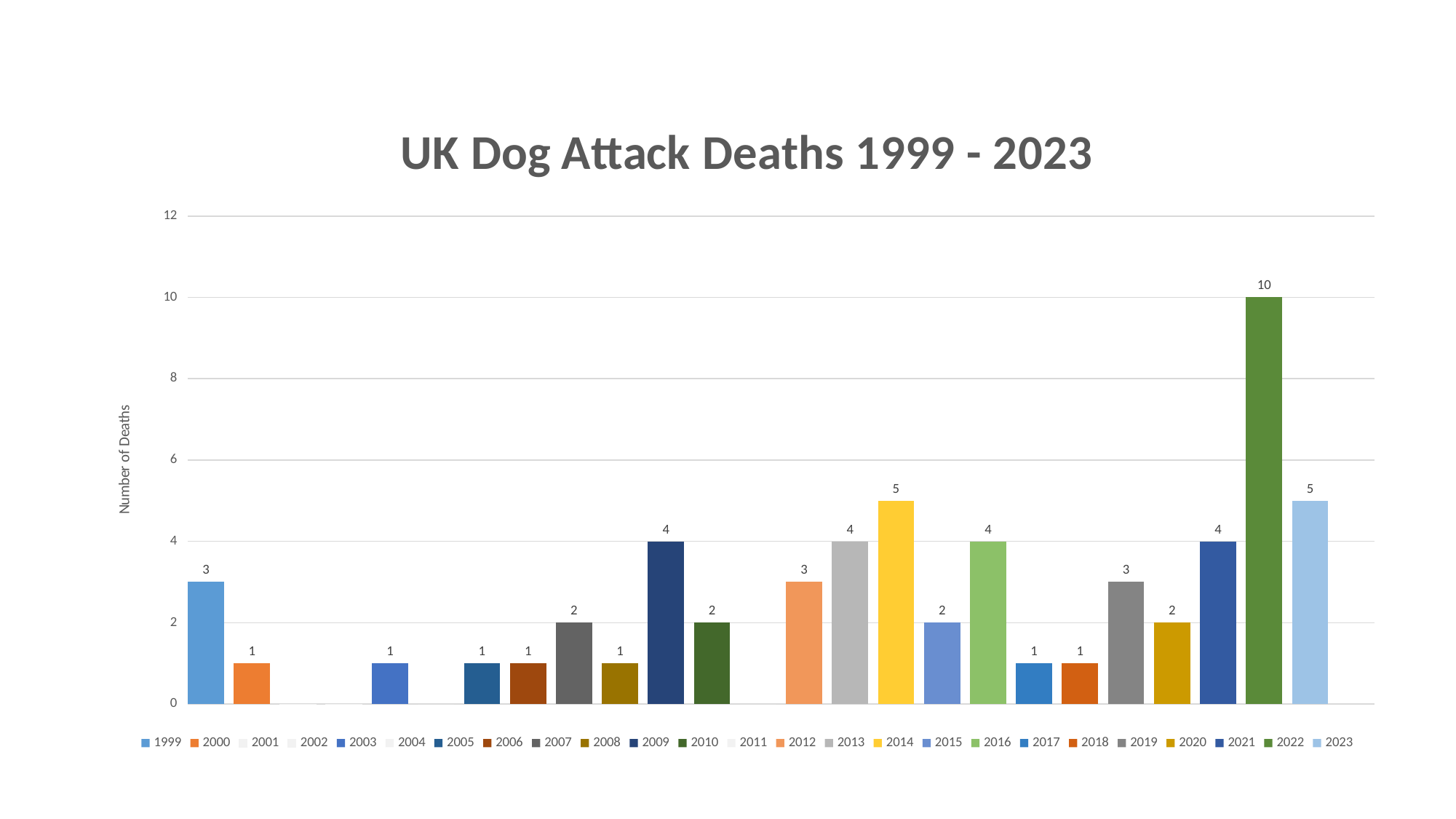
Is the value for 2022 greater or less than 8? greater What is the number of deaths shown for 2014? 5 How many years does the legend list? 25 What is the difference between the number of deaths in 2022 and in 2023? 5 Which year has more deaths, 2009 or 2010? 2009 What is the number of deaths shown for 1999? 3 What is the label on the vertical axis? Number of Deaths Which year has the highest number of deaths? 2022 What kind of chart is shown on the slide? bar chart Which year has more deaths, 2014 or 2019? 2014 What is the number of deaths shown for 2022? 10 What is the difference between the number of deaths in 2014 and in 2012? 2